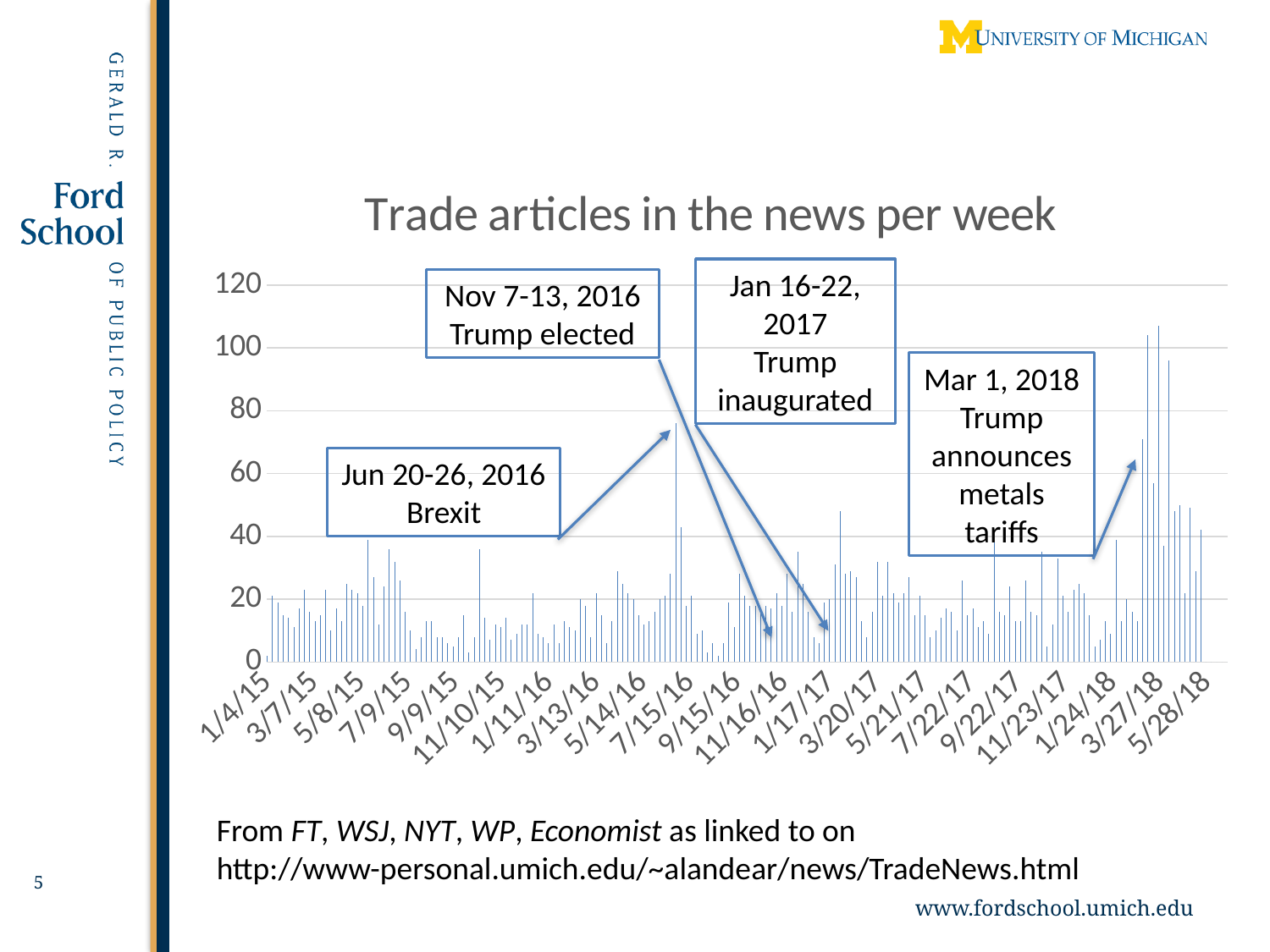
How many annotation boxes describing events are placed on the chart? 4 Around which x-axis label does the highest bar in the chart occur? 3/27/18 Which is larger: the tallest bar near 3/27/18 or the bar near 7/15/16 that the Brexit arrow points to? The bar near 3/27/18 Is the value of the bar near 1/17/17 that the 'Trump inaugurated' arrow points to greater or less than 40? less Is the value of the bar the Brexit annotation arrow points to (near 7/15/16) greater or less than 60? greater Is the value of the first bar in the chart (at 1/4/15) greater or less than 40? less What kind of chart is shown on the slide? Bar chart What is the title of the chart? Trade articles in the news per week Do the weekly values generally rise or fall toward the end of the period shown (2018)? rise